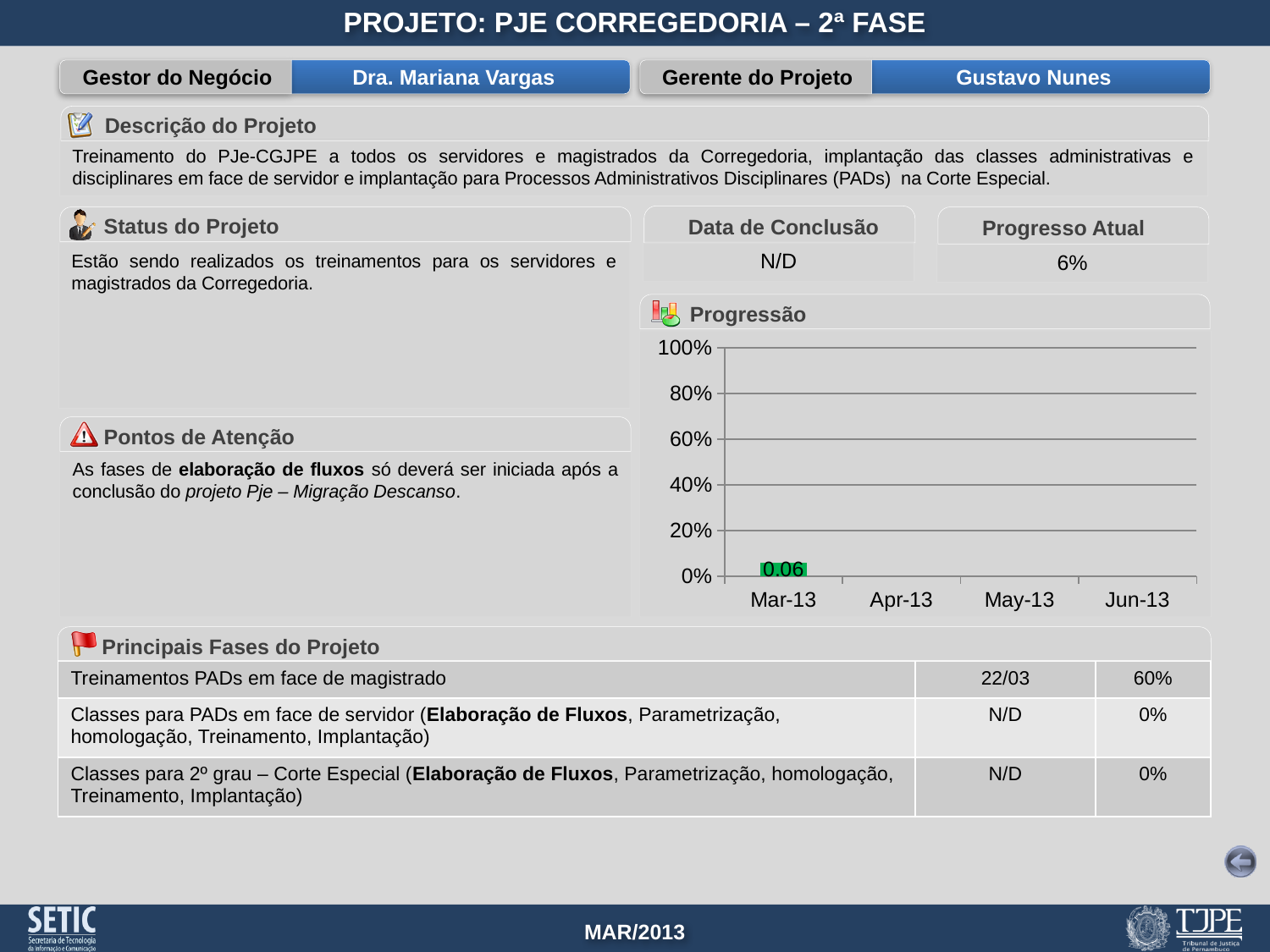
What kind of chart is the Progressão chart? bar chart Is the value for Mar-13 in the Progressão chart greater or less than 20%? less Which category in the Progressão chart has the highest value? Mar-13 What is the data label shown on the bar for Mar-13 in the Progressão chart? 0.06 What is the title of the chart on the slide? Progressão What is the highest value shown on the y axis of the Progressão chart? 100% Which is the last category on the x axis of the Progressão chart? Jun-13 Which is the first category on the x axis of the Progressão chart? Mar-13 How many bars are actually plotted in the Progressão chart? 1 How many categories are shown on the x axis of the Progressão chart? 4